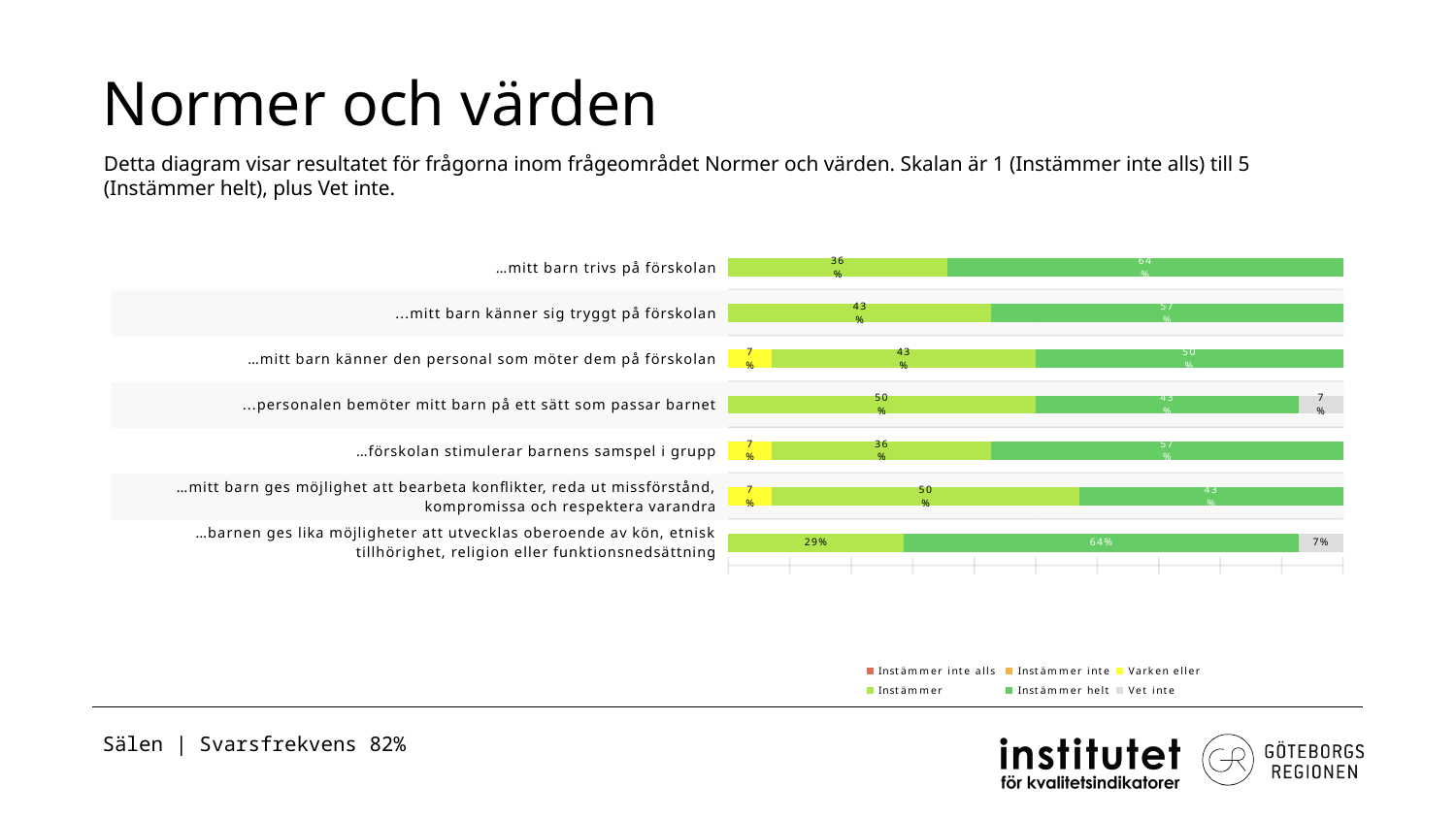
What is the "Instämmer" value for "…mitt barn känner sig tryggt på förskolan"? 43% For "…mitt barn trivs på förskolan", what is the difference between the "Instämmer helt" and "Instämmer" values? 28 percentage points What kind of chart is shown on the slide? Stacked bar chart What percentage of respondents answered "Instämmer helt" for "…mitt barn trivs på förskolan"? 64% What is the "Instämmer" value for "…förskolan stimulerar barnens samspel i grupp"? 36% What is the "Varken eller" value for "…mitt barn känner den personal som möter dem på förskolan"? 7% How many series does the legend list? 6 What is the "Vet inte" value for "…personalen bemöter mitt barn på ett sätt som passar barnet"? 7% How many question statements (categories) are shown in the chart? 7 Which has a larger "Instämmer helt" value: "…mitt barn trivs på förskolan" or "…mitt barn känner sig tryggt på förskolan"? …mitt barn trivs på förskolan What is the "Instämmer helt" value for "…barnen ges lika möjligheter att utvecklas oberoende av kön, etnisk tillhörighet, religion eller funktionsnedsättning"? 64% What is the total of the labelled segments for "…mitt barn känner sig tryggt på förskolan"? 100%